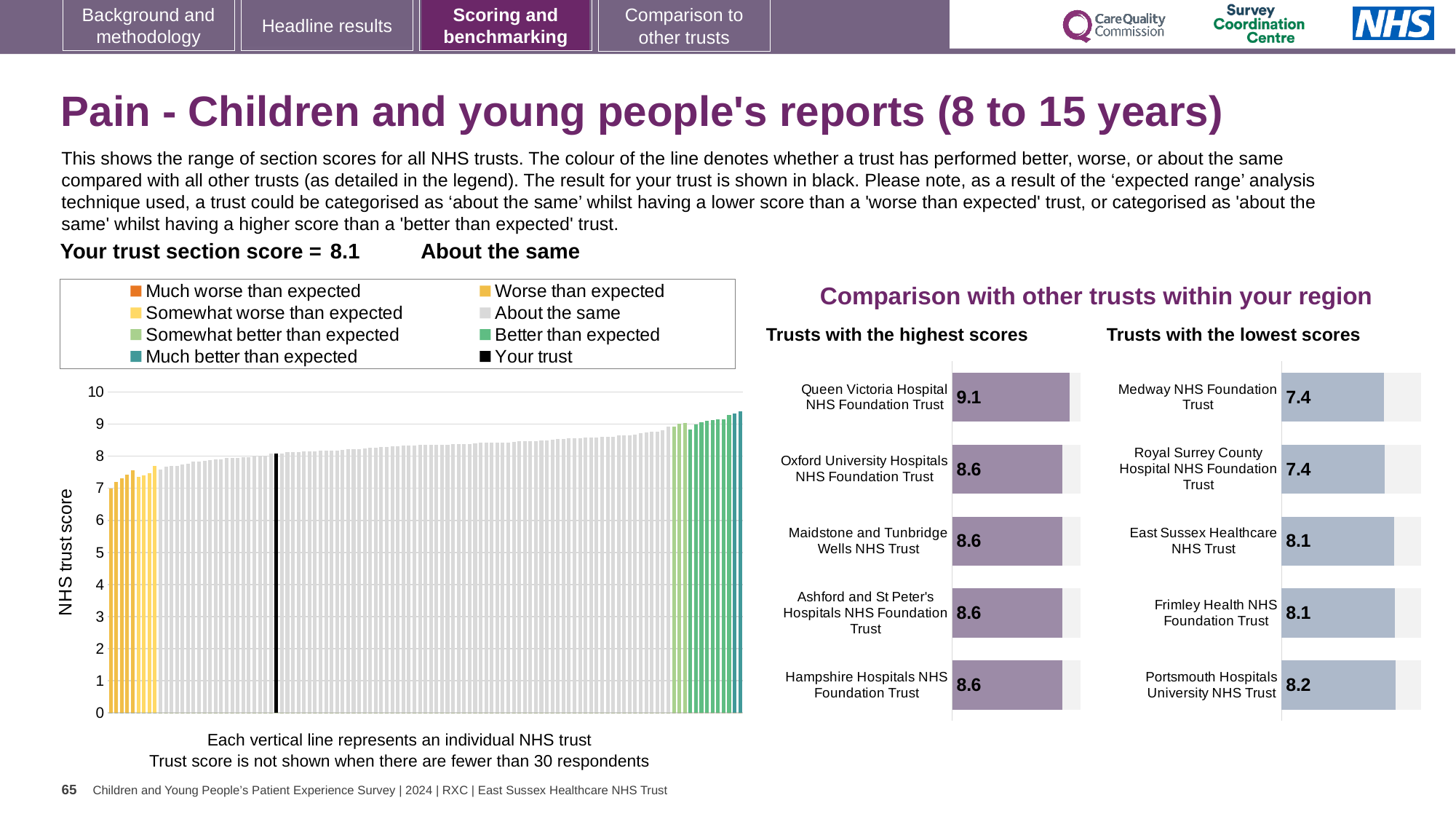
In the 'Trusts with the lowest scores' chart, what is the score for Portsmouth Hospitals University NHS Trust? 8.2 In the 'Trusts with the highest scores' chart, what is the difference between the scores of Queen Victoria Hospital NHS Foundation Trust and Oxford University Hospitals NHS Foundation Trust? 0.5 What kind of chart is the NHS trust score chart on the left? Bar chart In the NHS trust score chart on the left, is the value for the highest green bar greater or less than 9? greater In the 'Trusts with the lowest scores' chart, what is the difference between the scores of Portsmouth Hospitals University NHS Trust and Medway NHS Foundation Trust? 0.8 In the 'Trusts with the lowest scores' chart, which of Portsmouth Hospitals University NHS Trust and Medway NHS Foundation Trust has the larger score? Portsmouth Hospitals University NHS Trust How many trusts are listed in the 'Trusts with the lowest scores' chart? 5 In the 'Trusts with the highest scores' chart, what is the score for Hampshire Hospitals NHS Foundation Trust? 8.6 In the NHS trust score chart on the left, how many entries does the legend list? 8 In the 'Trusts with the highest scores' chart, what is the score for Queen Victoria Hospital NHS Foundation Trust? 9.1 In the 'Trusts with the lowest scores' chart, what is the score for Medway NHS Foundation Trust? 7.4 In the 'Trusts with the highest scores' chart, which trust has the highest score? Queen Victoria Hospital NHS Foundation Trust